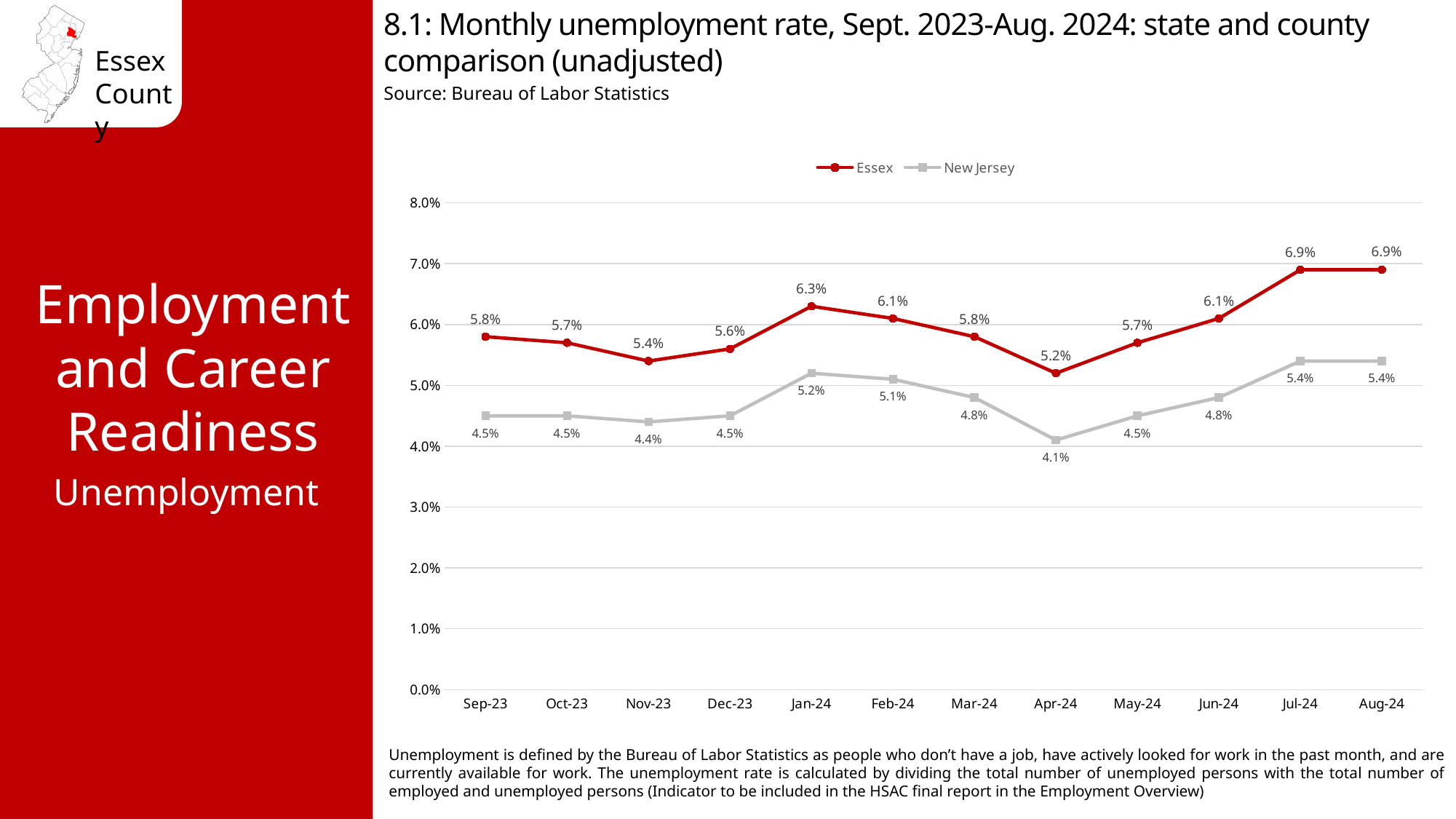
How many months are plotted on the x axis? 12 How many series does the legend list? 2 What was the Essex unemployment rate in Jan-24? 6.3% In which month was the New Jersey unemployment rate lowest? Apr-24 Did the Essex unemployment rate rise or fall from Apr-24 to Aug-24? Rise What is the difference between the Essex rate in Jul-24 and the Essex rate in Sep-23? 1.1% Which series had the higher unemployment rate in Mar-24, Essex or New Jersey? Essex In which month was the Essex unemployment rate lowest? Apr-24 What was the New Jersey unemployment rate in Apr-24? 4.1% What kind of chart is shown on the slide? Line chart What was the Essex unemployment rate in Nov-23? 5.4% What is the difference between the Essex and New Jersey unemployment rates in Aug-24? 1.5%